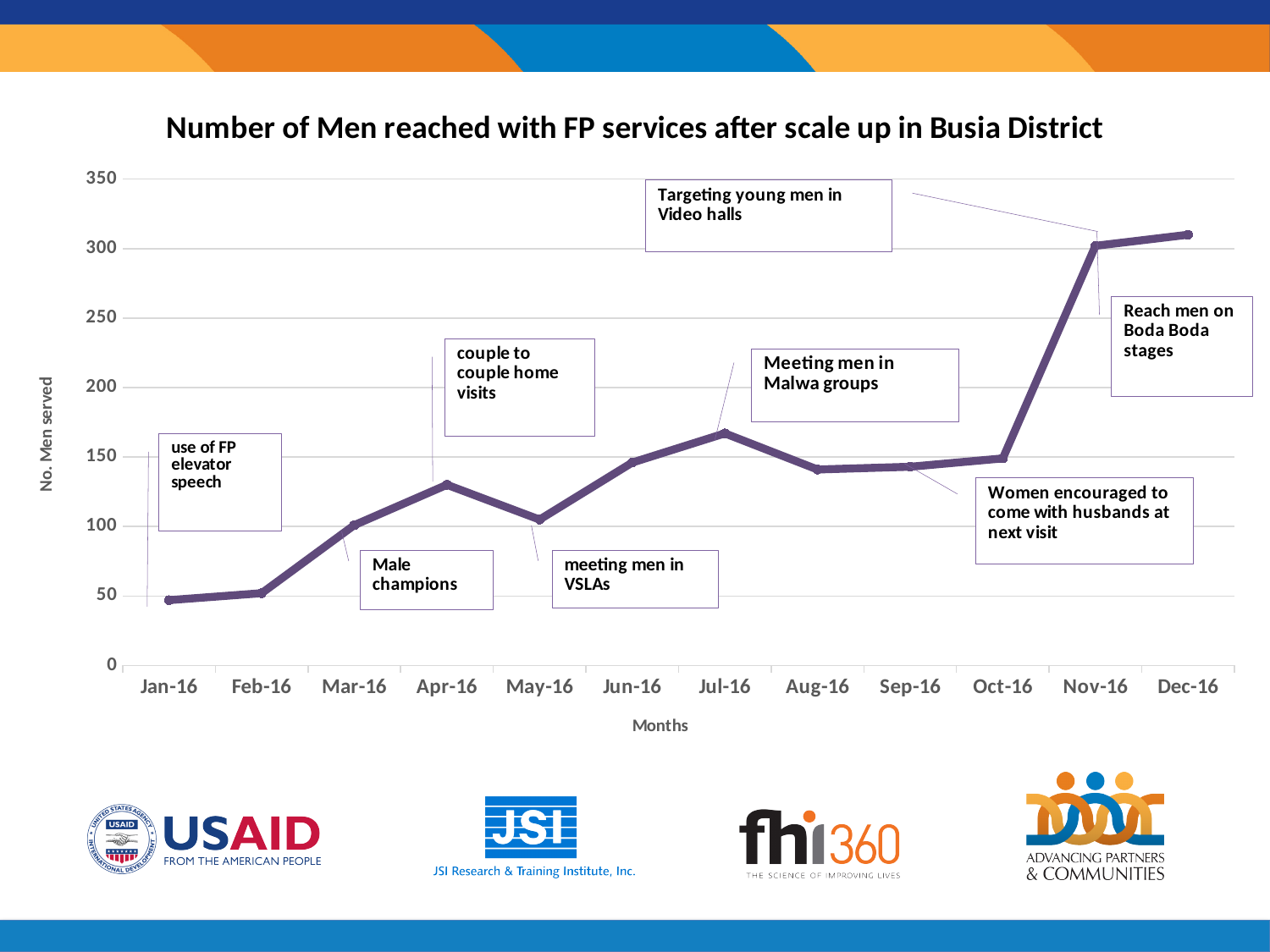
Overall, do the values rise or fall from Jan-16 to Dec-16? Rise Which month has the higher value, Oct-16 or Nov-16? Nov-16 What type of chart is shown on the slide? Line chart Is the value for Apr-16 greater or less than 100? greater Is the value for Jul-16 greater or less than 150? greater Is the value for Nov-16 greater or less than 250? greater What is the label on the y axis of the chart? No. Men served Which month has the higher value, Apr-16 or May-16? Apr-16 How many months are plotted along the x axis? 12 Which month has the highest number of men served? Dec-16